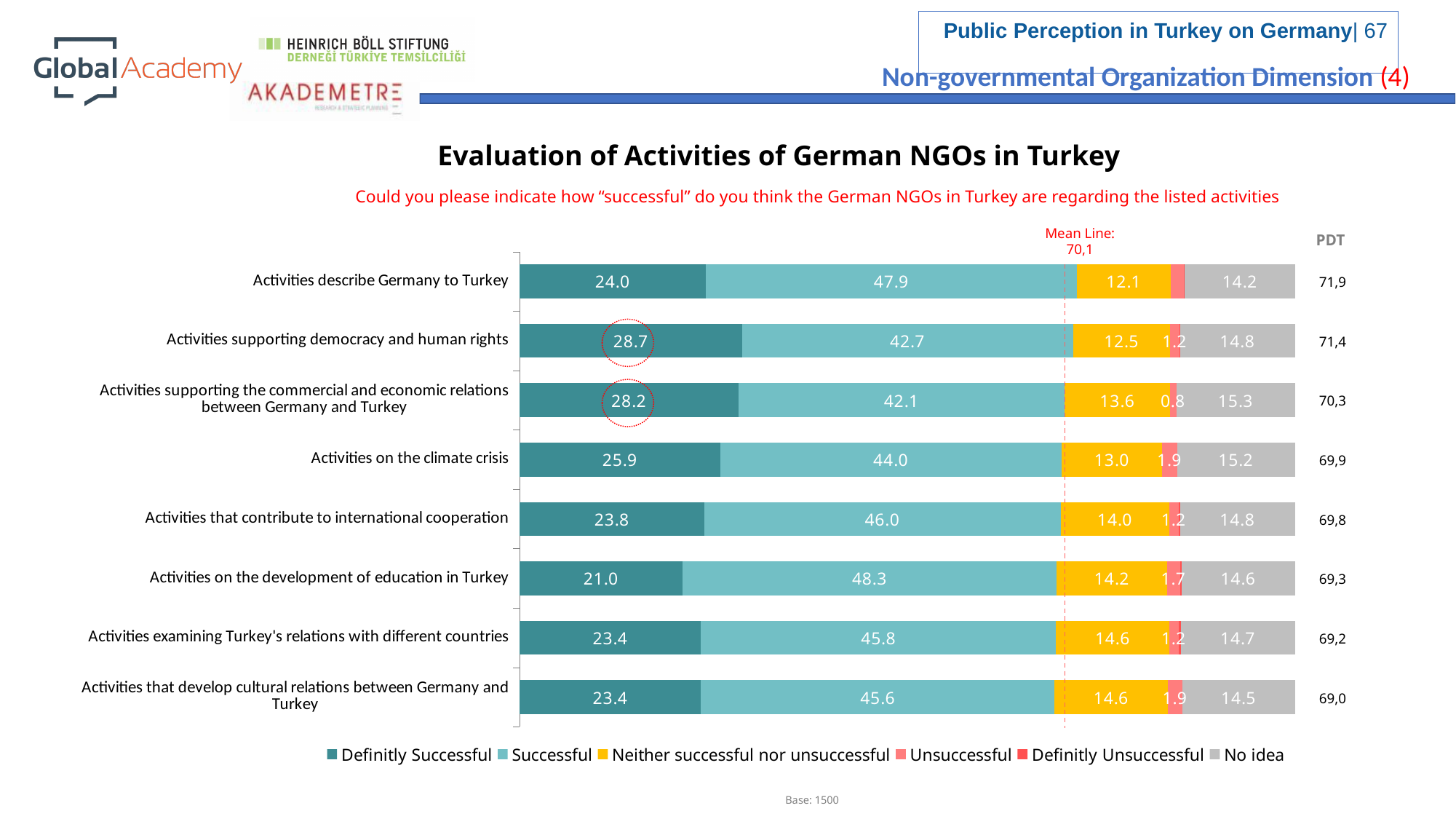
How many series does the legend list? 6 Which has a larger "Successful" value: "Activities describe Germany to Turkey" or "Activities that contribute to international cooperation"? Activities describe Germany to Turkey What is the "No idea" value for "Activities supporting the commercial and economic relations between Germany and Turkey"? 15.3 What is the value of the Mean Line shown on the chart? 70,1 What is the PDT value shown for "Activities on the climate crisis"? 69,9 What kind of chart is shown on the slide? Stacked bar chart What is the difference between the "Definitly Successful" values for "Activities supporting democracy and human rights" and "Activities describe Germany to Turkey"? 4.7 Which activity has the highest "Definitly Successful" value? Activities supporting democracy and human rights What is the "Definitly Successful" value for "Activities supporting democracy and human rights"? 28.7 What is the "Successful" value for "Activities on the development of education in Turkey"? 48.3 How many activities are listed in the chart? 8 Which activity has the lowest "Definitly Successful" value? Activities on the development of education in Turkey